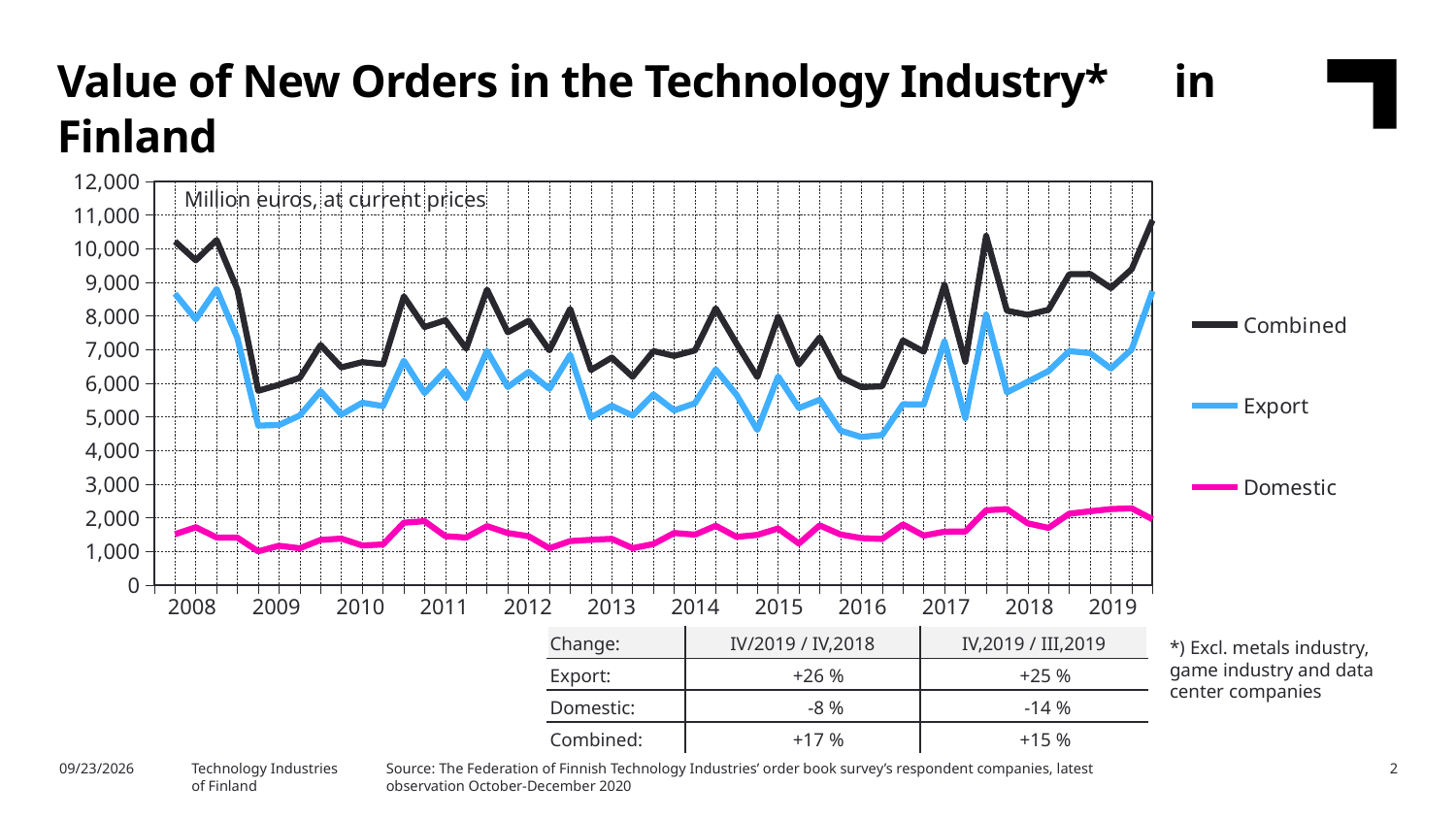
What unit is stated inside the chart area? Million euros, at current prices What kind of chart is shown on the slide? line chart Which series has the highest values throughout the chart? Combined Is the Domestic series ever greater or less than 3,000 over the whole period? less Is the value of the Combined series at the end of 2019 greater or less than 10,000? greater What are the three series named in the legend? Combined, Export, Domestic Is the lowest value of the Export series, around 2016, greater or less than 5,000? less Which series has the lowest values throughout the chart? Domestic How many years are labelled on the x axis? 12 How many series does the legend list? 3 Which is larger in 2019, the Export series or the Domestic series? Export Does the Combined series rise or fall from 2016 to 2019? rise